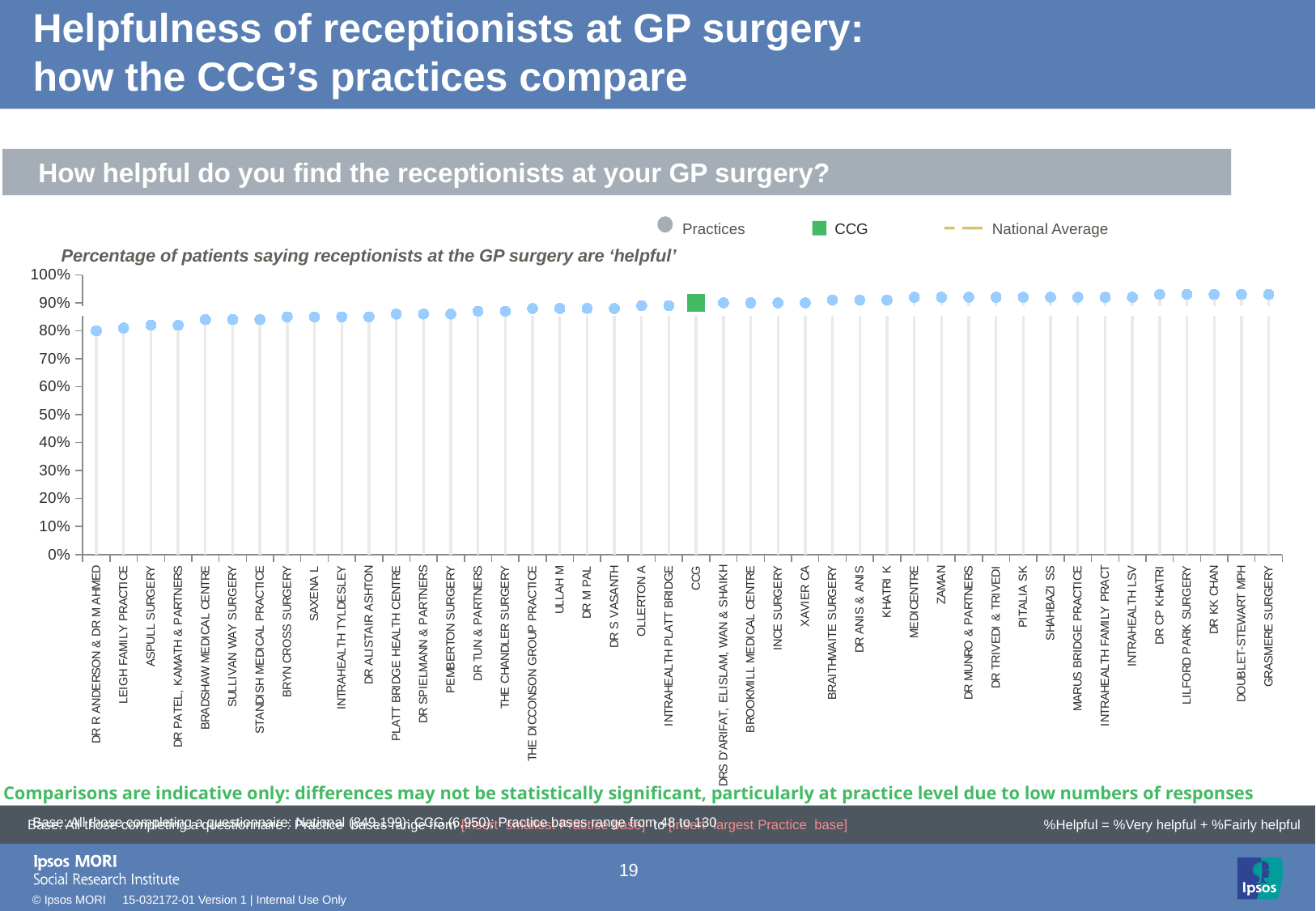
Is the value for LEIGH FAMILY PRACTICE greater or less than 70%? greater Is the value for DR R ANDERSON & DR M AHMED greater or less than 90%? less Do the plotted values rise or fall moving from left to right along the x axis? rise Which has the higher value, GRASMERE SURGERY or DR R ANDERSON & DR M AHMED? GRASMERE SURGERY Is the value for ASPULL SURGERY greater or less than 90%? less What colour is the marker used for the CCG in the chart? green Which has the higher value, DR KK CHAN or LEIGH FAMILY PRACTICE? DR KK CHAN Which practice has the lowest percentage of patients saying receptionists are 'helpful'? DR R ANDERSON & DR M AHMED Which category is plotted immediately to the right of CCG on the x axis? DRS D'ARIFAT, ELISLAM, WAN & SHAIKH How many entries does the chart legend list? 3 What is the highest value shown on the y axis? 100%